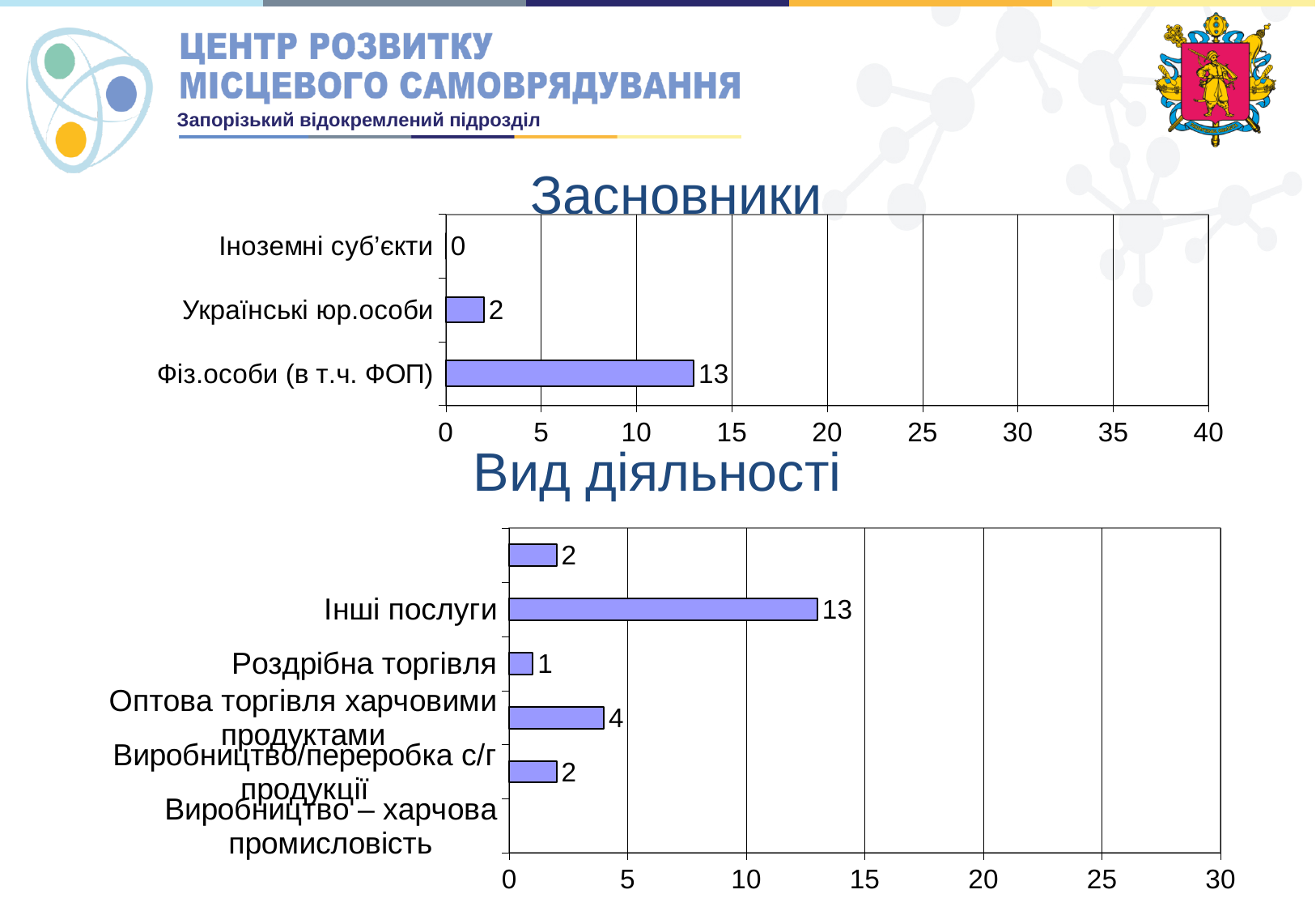
What type of chart is the 'Засновники' chart? Bar chart On the 'Вид діяльності' chart, what is the value for 'Оптова торгівля харчовими продуктами'? 4 On the 'Засновники' chart, what is the value for 'Українські юр.особи'? 2 On the 'Засновники' chart, which category has the highest value? Фіз.особи (в т.ч. ФОП) On the 'Вид діяльності' chart, which is larger: 'Інші послуги' or 'Оптова торгівля харчовими продуктами'? Інші послуги How many categories are shown on the 'Засновники' chart? 3 On the 'Засновники' chart, what is the value for 'Іноземні суб’єкти'? 0 On the 'Засновники' chart, what is the value for 'Фіз.особи (в т.ч. ФОП)'? 13 On the 'Вид діяльності' chart, what is the value for 'Інші послуги'? 13 On the 'Засновники' chart, which category has the lowest value? Іноземні суб’єкти On the 'Вид діяльності' chart, what is the value for 'Роздрібна торгівля'? 1 On the 'Засновники' chart, what is the difference between 'Фіз.особи (в т.ч. ФОП)' and 'Українські юр.особи'? 11